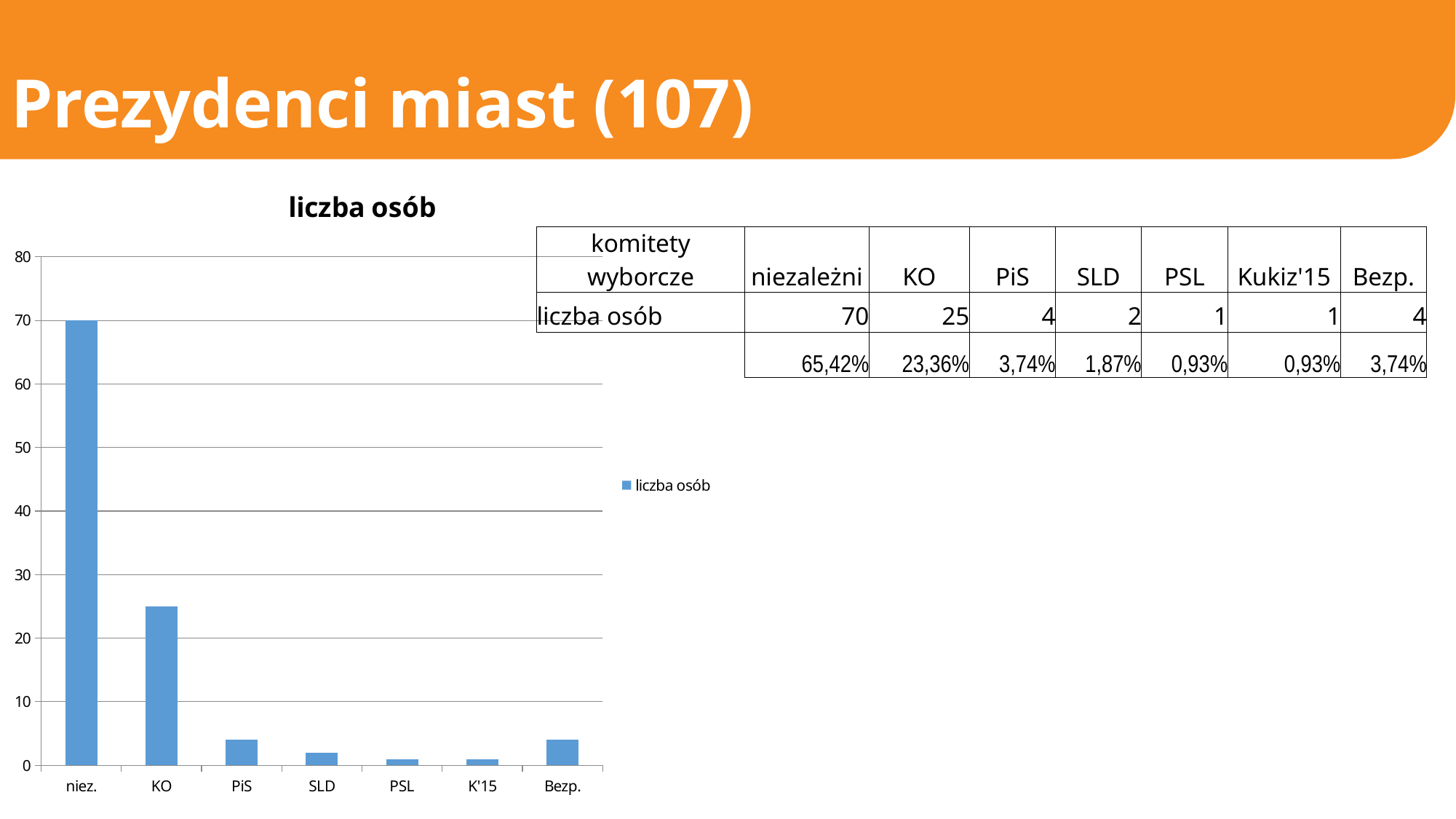
How many series does the chart legend list? 1 What is the value for SLD in the chart? 2 Is the value for niez. greater or less than 60? greater What is the difference between the values for niez. and KO? 45 Is the value for KO greater or less than 30? less What is the value for niez. in the chart? 70 What is the title of the chart? liczba osób What kind of chart is shown on the slide? bar chart Which is larger, the value for PiS or the value for SLD? PiS What is the value for KO in the chart? 25 Which category has the highest value in the chart? niez. How many categories are shown on the x axis of the chart? 7